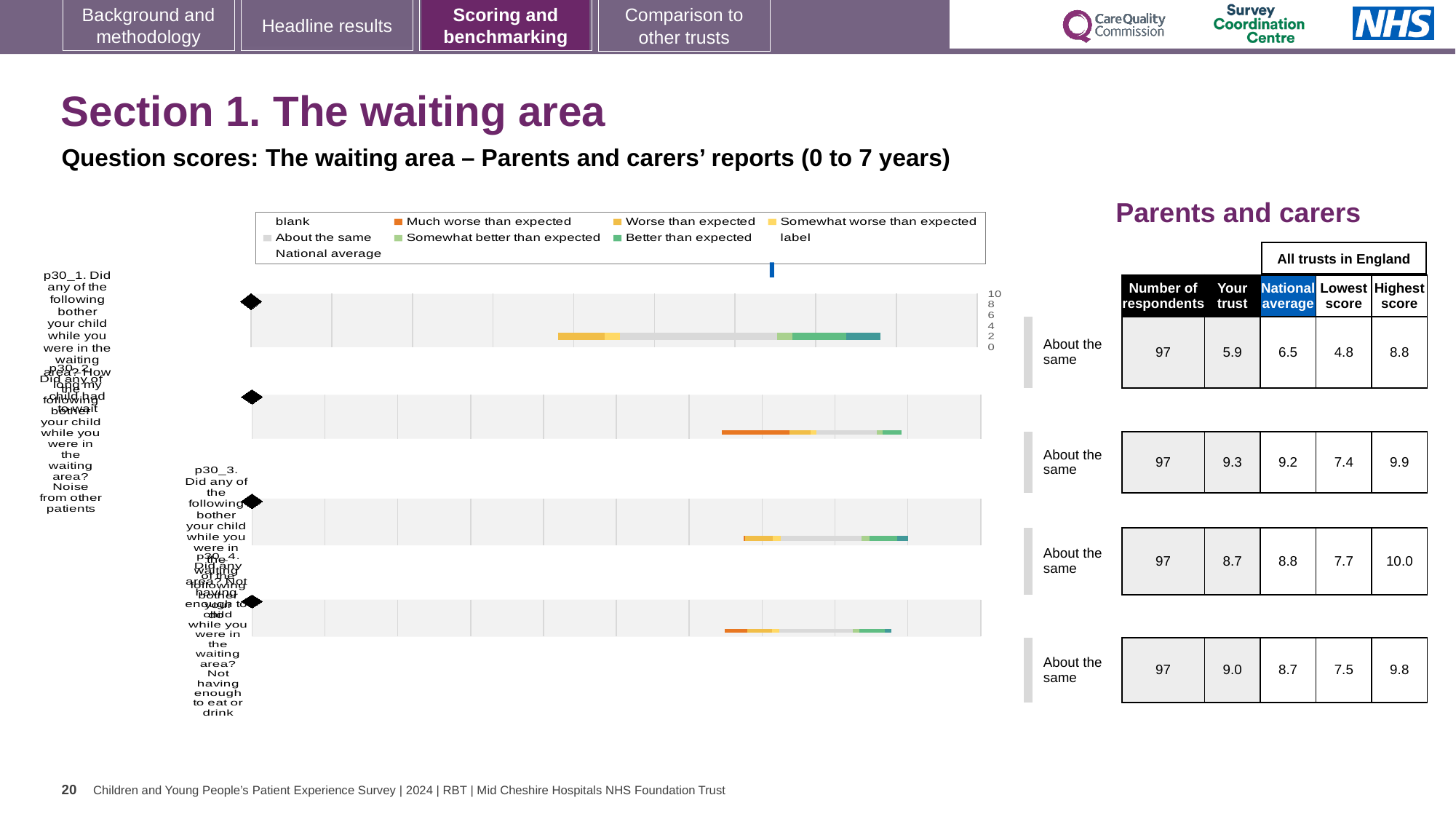
How many respondents are listed for each of the four questions? 97 What kind of chart is used to show the question scores on this slide? bar chart Which question has the lowest 'Your trust' score in the table? p30_1 In the table beside the charts, what is the lowest score for the fourth question (p30_4)? 7.5 In the table beside the charts, what is the 'Your trust' score for the first question (p30_1)? 5.9 In the table beside the charts, what is the highest score for the third question (p30_3)? 10.0 Which legend entry is shown in light grey? About the same How many separate question charts are shown on the slide? 4 For the fourth question (p30_4), what is the difference between the 'Your trust' score and the national average? 0.3 In the table beside the charts, what is the national average for the second question (p30_2)? 9.2 Which legend entry is shown in orange? Much worse than expected Which question has the highest 'Your trust' score in the table? p30_2